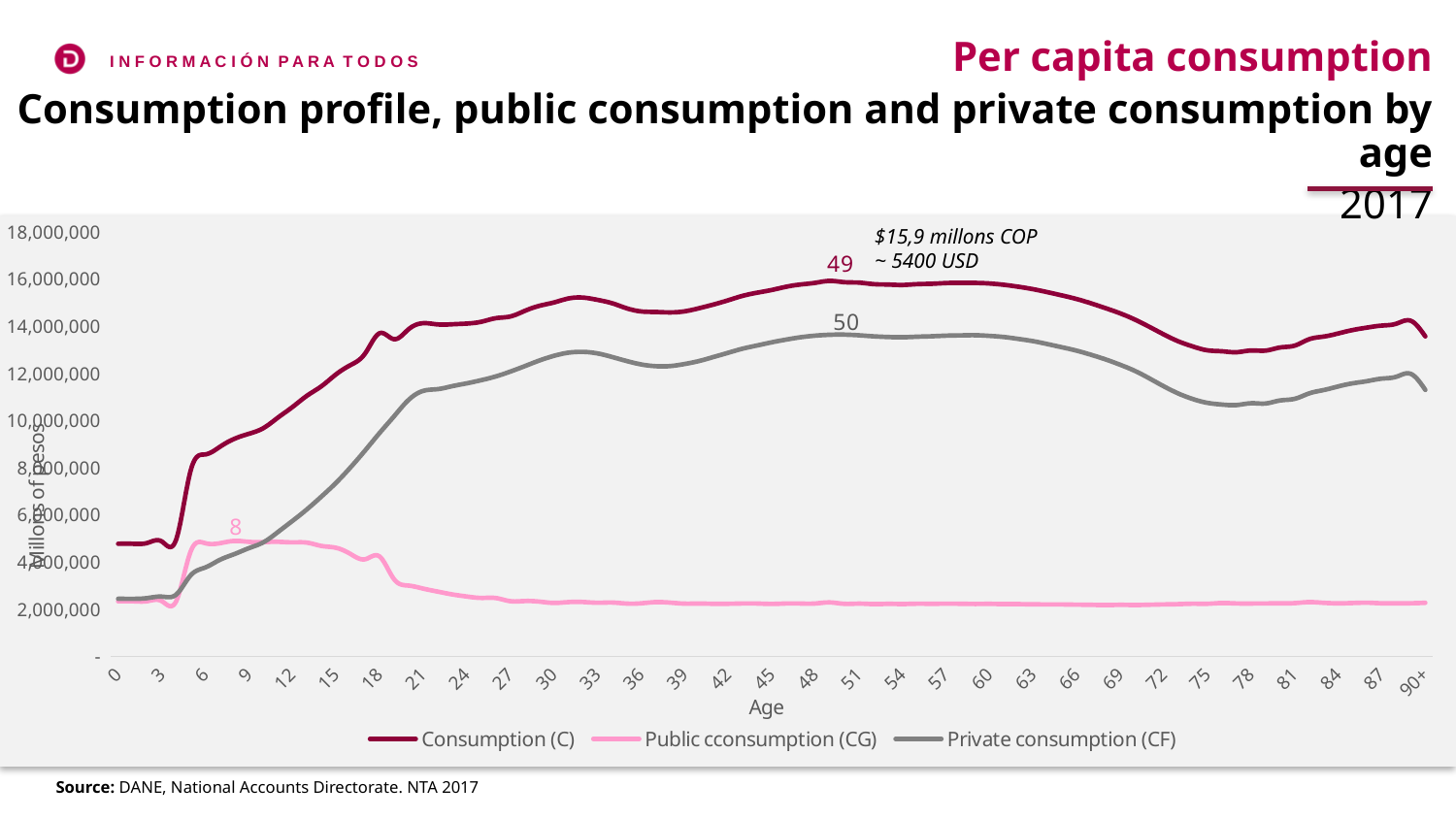
According to the label on the chart, at what age does the Consumption (C) line reach its peak? 49 What type of chart is shown on the slide? line chart How many series does the legend list? 3 According to the label on the chart, at what age does the Private consumption (CF) line reach its peak? 50 Does the Private consumption (CF) line rise or fall between age 60 and age 75? fall Which series has the lowest value at age 60? Public consumption (CG) Is the value for Consumption (C) at age 48 greater or less than 14,000,000? greater According to the label on the chart, at what age does the Public consumption (CG) line reach its peak? 8 Is the value for Consumption (C) at age 0 greater or less than 6,000,000? less At age 6, which is larger: Public consumption (CG) or Private consumption (CF)? Public consumption (CG) What annotation is printed near the peak of the Consumption (C) line? $15,9 millons COP ~ 5400 USD Which series has the highest value at age 30? Consumption (C)